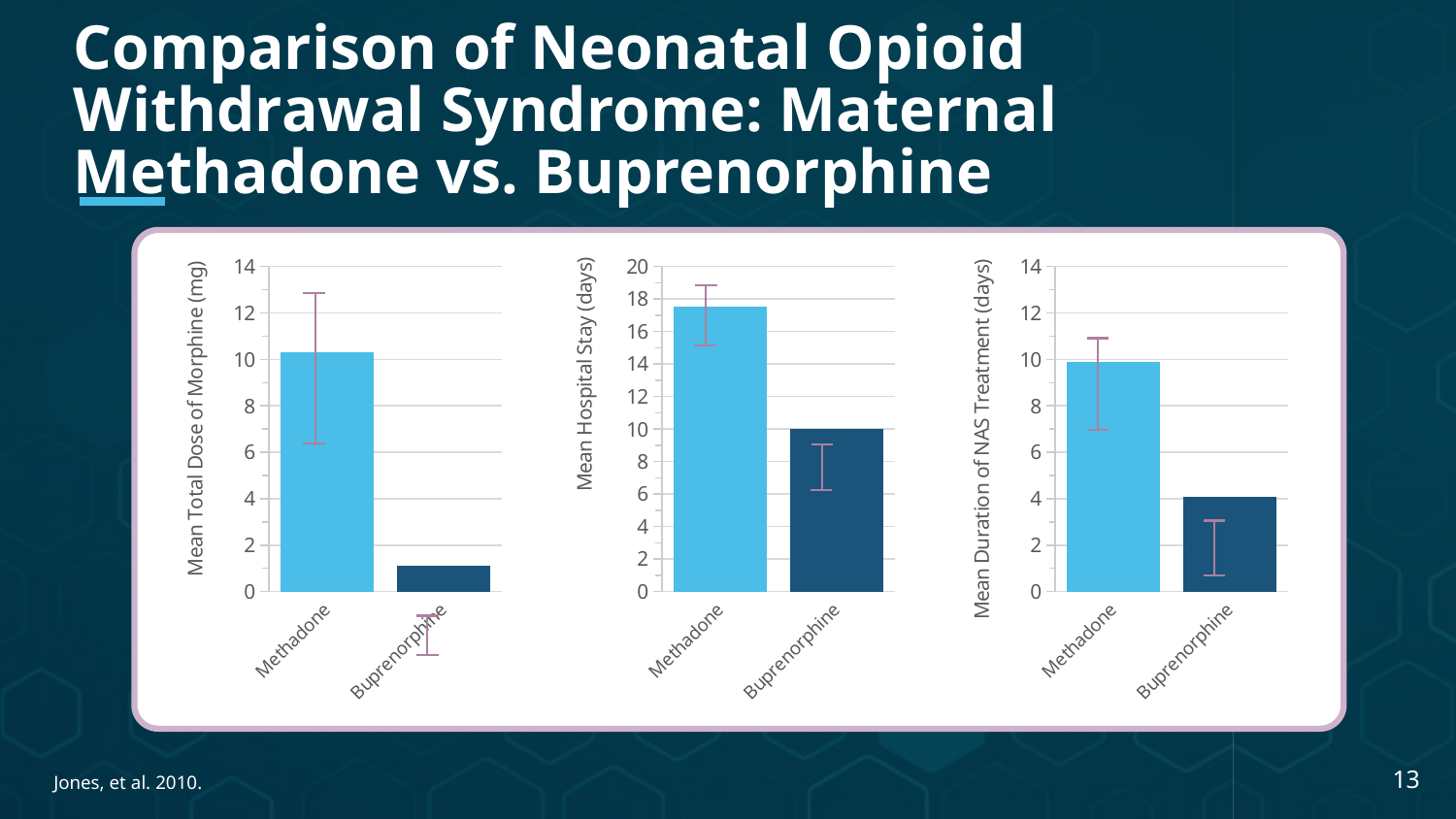
On the right chart (Mean Duration of NAS Treatment), is the value for Methadone greater or less than 8? greater On the right chart (Mean Duration of NAS Treatment), is the value for Buprenorphine greater or less than 6? less On the left chart (Mean Total Dose of Morphine), is the value for Buprenorphine greater or less than 2? less How many categories are shown on the x axis of the middle chart (Mean Hospital Stay)? 2 On the left chart (Mean Total Dose of Morphine), which category has the higher bar? Methadone How many charts are shown on the slide? 3 What is the y-axis label of the middle chart? Mean Hospital Stay (days) What kind of chart is the left chart (Mean Total Dose of Morphine)? bar chart On the middle chart (Mean Hospital Stay), which category has the lower bar? Buprenorphine On the right chart (Mean Duration of NAS Treatment), which is larger, the value for Methadone or for Buprenorphine? Methadone